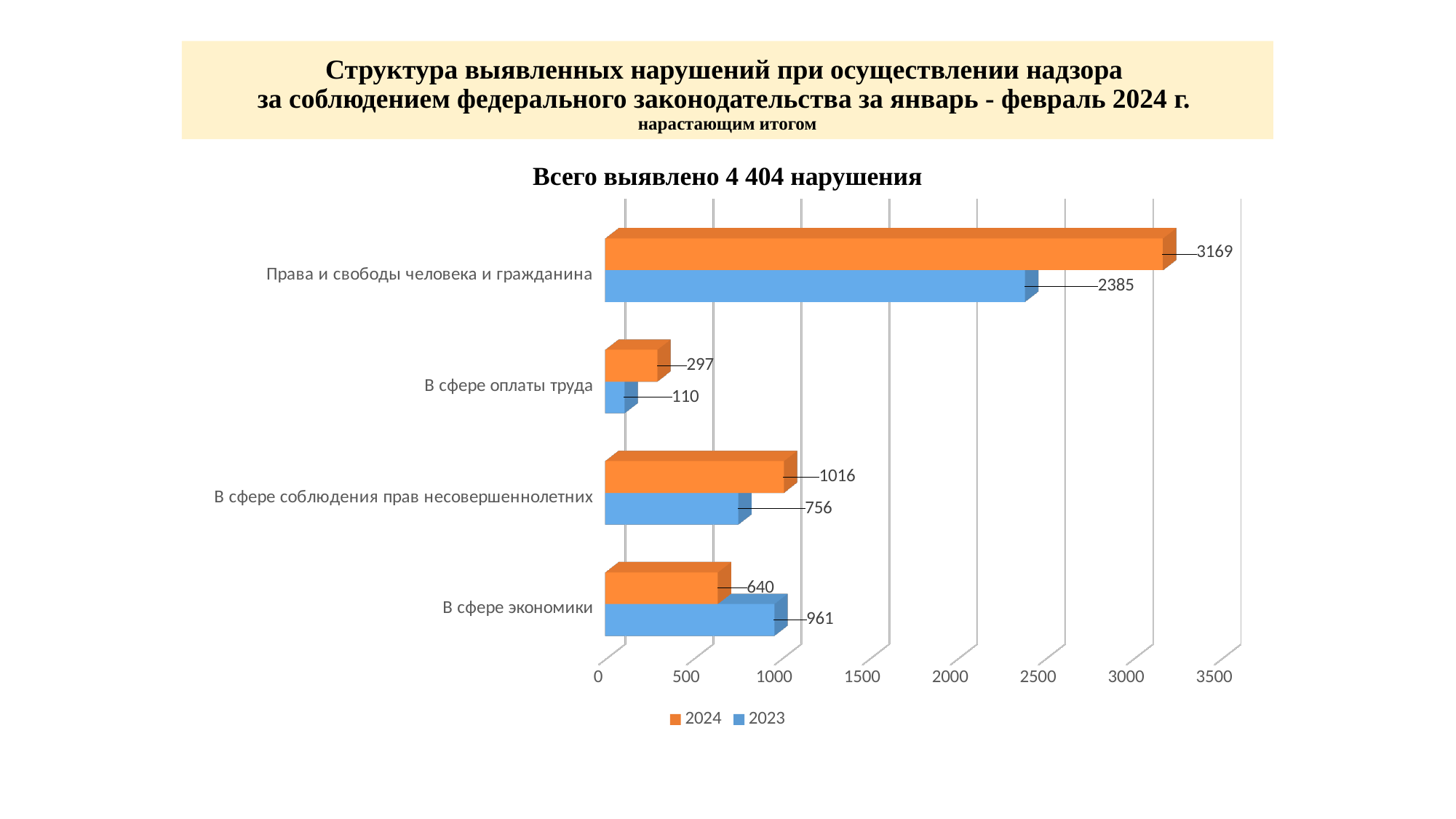
What is the 2023 value for «В сфере оплаты труда»? 110 How many categories are shown on the chart? 4 How many series does the legend list? 2 What is the 2024 value for «Права и свободы человека и гражданина»? 3169 Which category has the lowest 2023 value? В сфере оплаты труда What is the difference between the 2024 and 2023 values for «Права и свободы человека и гражданина»? 784 What is the 2023 value for «В сфере экономики»? 961 What total number of violations is stated in the chart title? 4 404 What kind of chart is shown on the slide? Bar chart Which category has the highest 2024 value? Права и свободы человека и гражданина What is the 2024 value for «В сфере соблюдения прав несовершеннолетних»? 1016 Which is larger for «В сфере экономики»: the 2024 value or the 2023 value? 2023